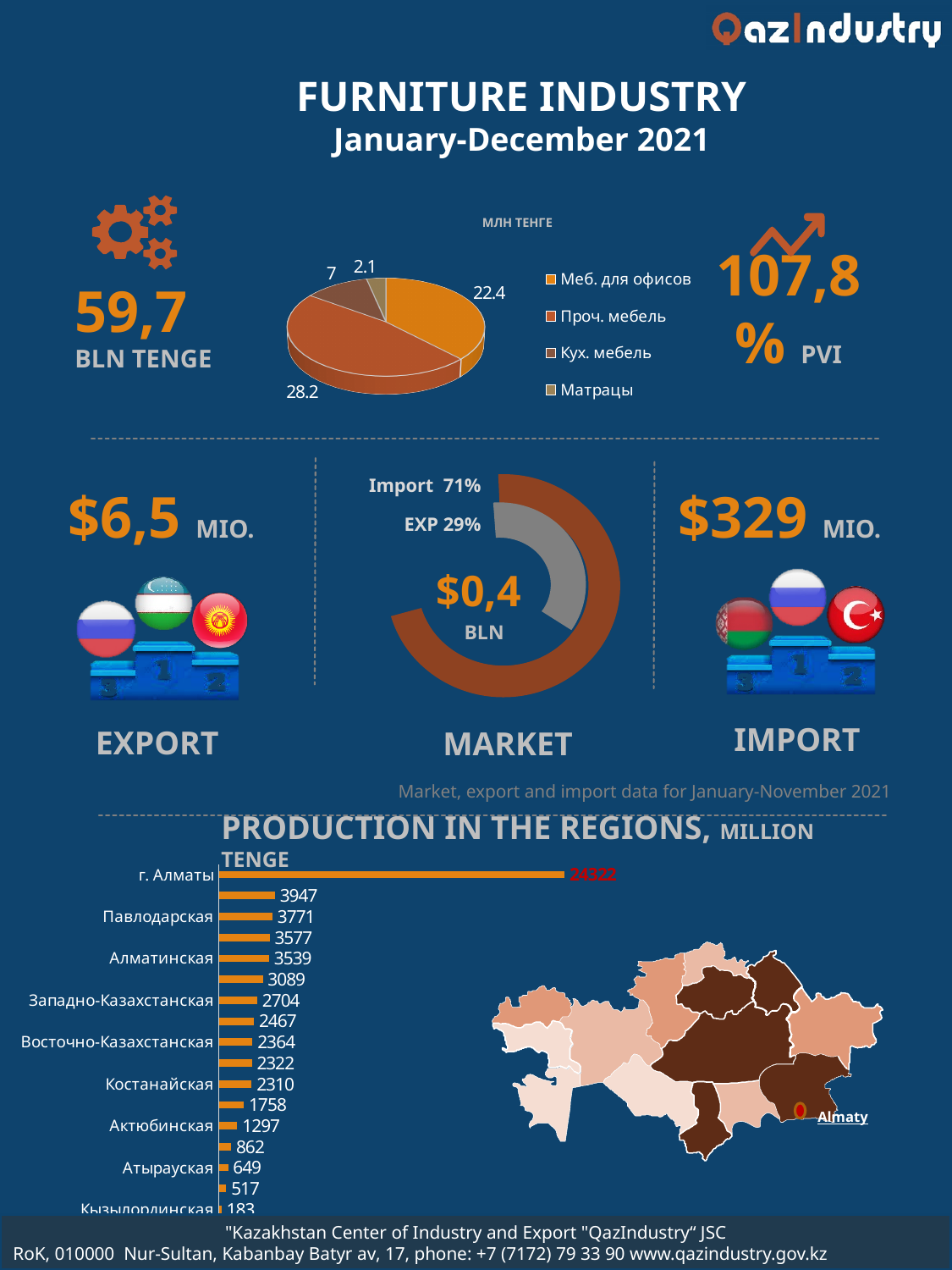
In the pie chart labelled МЛН ТЕНГЕ, which category has the largest value? Проч. мебель In the PRODUCTION IN THE REGIONS chart, what is the value for г. Алматы? 24322 In the PRODUCTION IN THE REGIONS chart, which is larger: the value for Алматинская or the value for Костанайская? Алматинская What kind of chart is the chart labelled МЛН ТЕНГЕ in the top section? Pie chart In the pie chart labelled МЛН ТЕНГЕ, what is the difference between the values for Проч. мебель and Меб. для офисов? 5.8 How many categories does the legend of the pie chart labelled МЛН ТЕНГЕ list? 4 In the MARKET donut chart, what share is shown for EXP? 29% In the PRODUCTION IN THE REGIONS chart, what is the value for Павлодарская? 3771 In the pie chart labelled МЛН ТЕНГЕ, which category has the smallest value? Матрацы In the pie chart labelled МЛН ТЕНГЕ, what value is shown for Меб. для офисов? 22.4 In the MARKET donut chart, what share is shown for Import? 71% In the PRODUCTION IN THE REGIONS chart, which region has the lowest value? Кызылординская